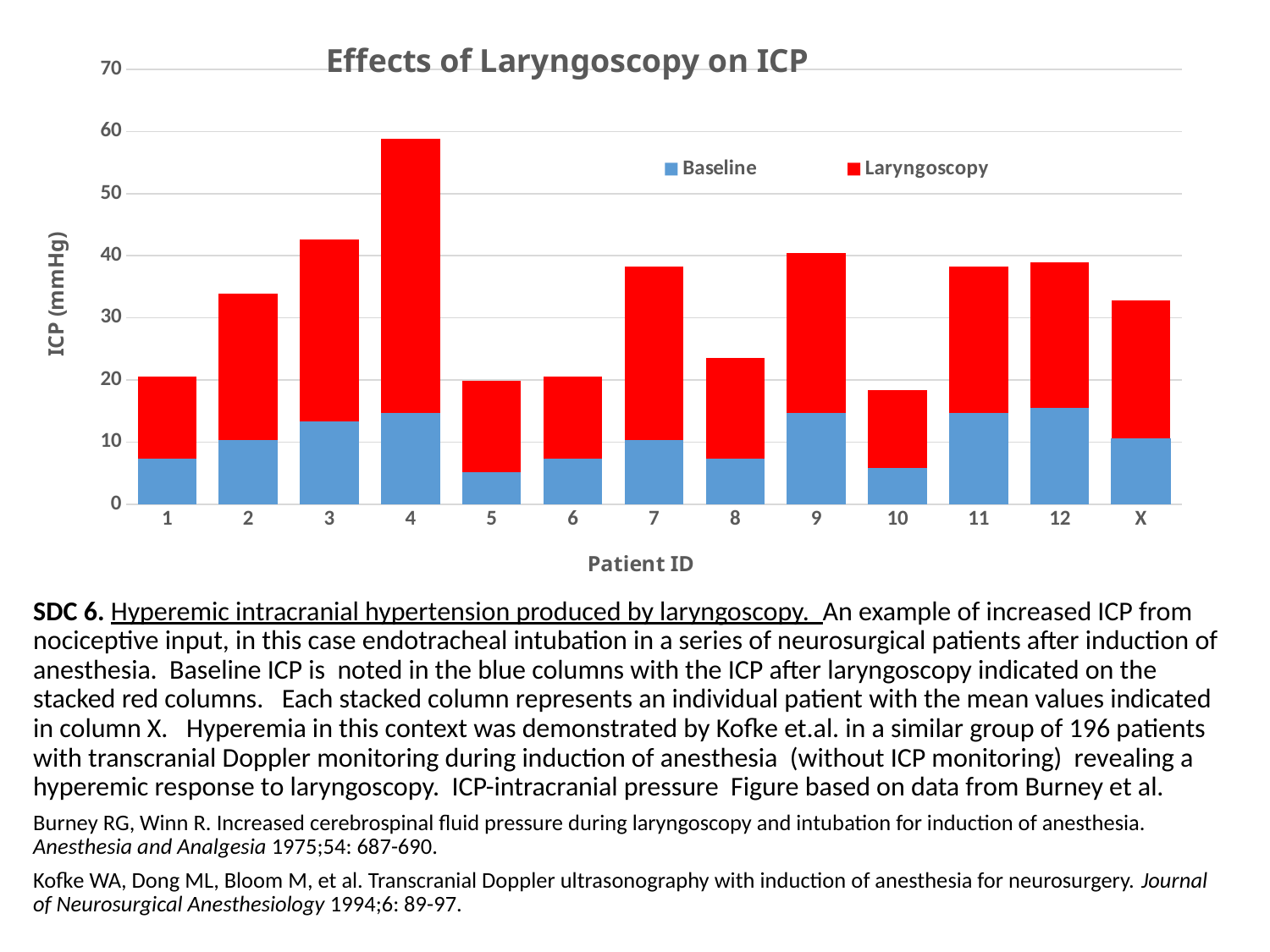
How many series does the chart legend list? 2 Which colour represents the Laryngoscopy series in the chart? red Is the total stacked value for patient 10 greater or less than 20? less What kind of chart is shown on the slide? stacked bar chart Which patient has the highest total stacked bar in the chart? 4 How many patient categories are shown on the x axis of the chart? 13 Is the total stacked value for patient 4 greater or less than 50? greater Which has the larger total stacked bar, patient 2 or patient 8? patient 2 Is the Baseline value for patient 1 greater or less than 10? less What is the title of the chart? Effects of Laryngoscopy on ICP